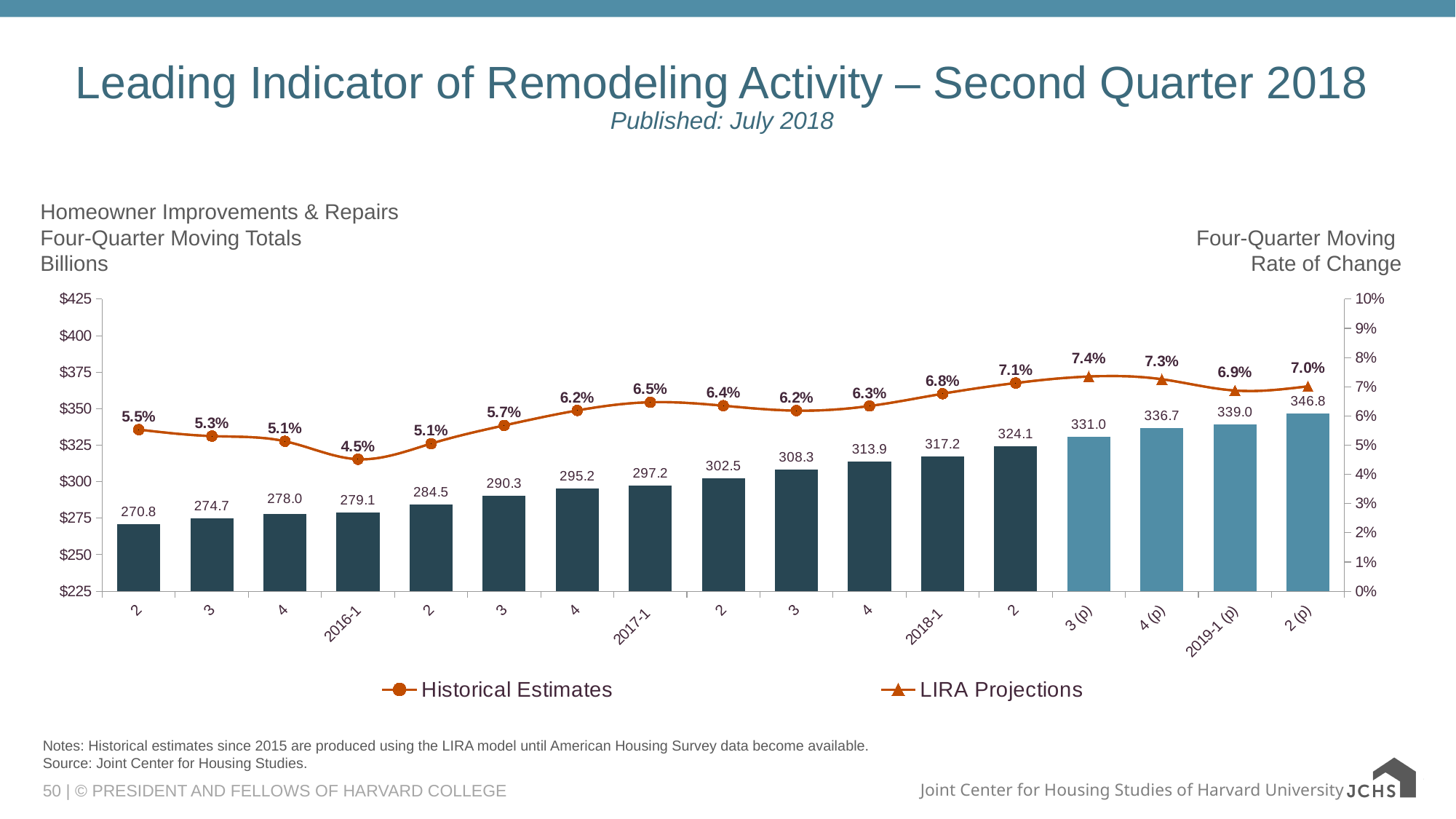
Which quarter has the tallest bar for four-quarter moving totals? 2 (p) What is the four-quarter moving total (in billions) shown for 2018-1? 317.2 Which quarter has the highest four-quarter moving rate of change on the line? 3 (p) Which is larger, the rate of change for 2017-1 or for 2016-1? 2017-1 What is the difference between the bar values for 2018-1 and 2017-1? 20.0 What is the difference between the bar values for 2 (p) and 2018-2 (the bar labeled 2 after 2018-1)? 22.7 How many series does the legend list? 2 Is the bar value for 2016-1 greater or less than $300? less Which quarter has the lowest four-quarter moving rate of change on the line? 2016-1 How many bars are plotted in the chart? 17 What is the four-quarter moving rate of change shown for 2016-1? 4.5% Do the four-quarter moving total bars generally rise or fall from left to right? rise